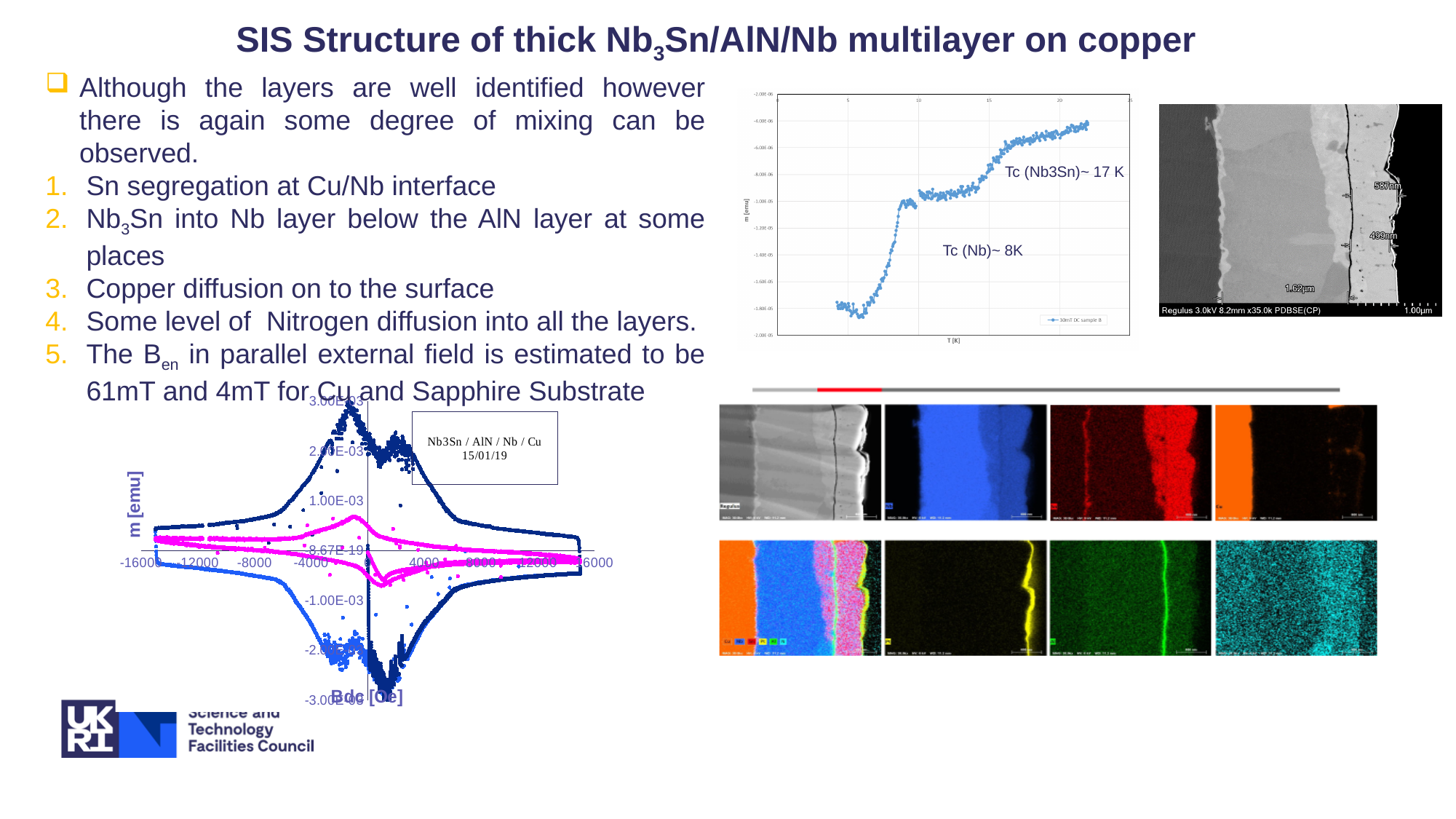
In the top-right chart of m [emu] versus T [K], is the plotted value at T = 5 K greater or less than -1.60E-05? less In the top-right chart of m [emu] versus T [K], what transition temperature is annotated for Nb3Sn? ~ 17 K In the bottom-left chart of m [emu] versus Bdc [Oe], what sample and date are written in the text box inside the plot? Nb3Sn / AlN / Nb / Cu 15/01/19 In the top-right chart of m [emu] versus T [K], do the plotted values rise or fall as temperature increases along the x axis? rise In the top-right chart of m [emu] versus T [K], is the plotted value at T = 20 K greater or less than -6.00E-06? greater In the top-right chart of m [emu] versus T [K], what transition temperature is annotated for Nb? ~ 8K In the bottom-left chart of m [emu] versus Bdc [Oe], what is the highest value labelled on the y axis? 3.00E-03 In the bottom-left chart of m [emu] versus Bdc [Oe], what is the maximum value shown on the x axis? 16000 In the top-right chart of m [emu] versus T [K], how many series does the legend list? 1 What kind of chart is the bottom-left chart of m [emu] versus Bdc [Oe]? scatter chart In the top-right chart of m [emu] versus T [K], what is the legend entry for the plotted series? 30mT DC sample B